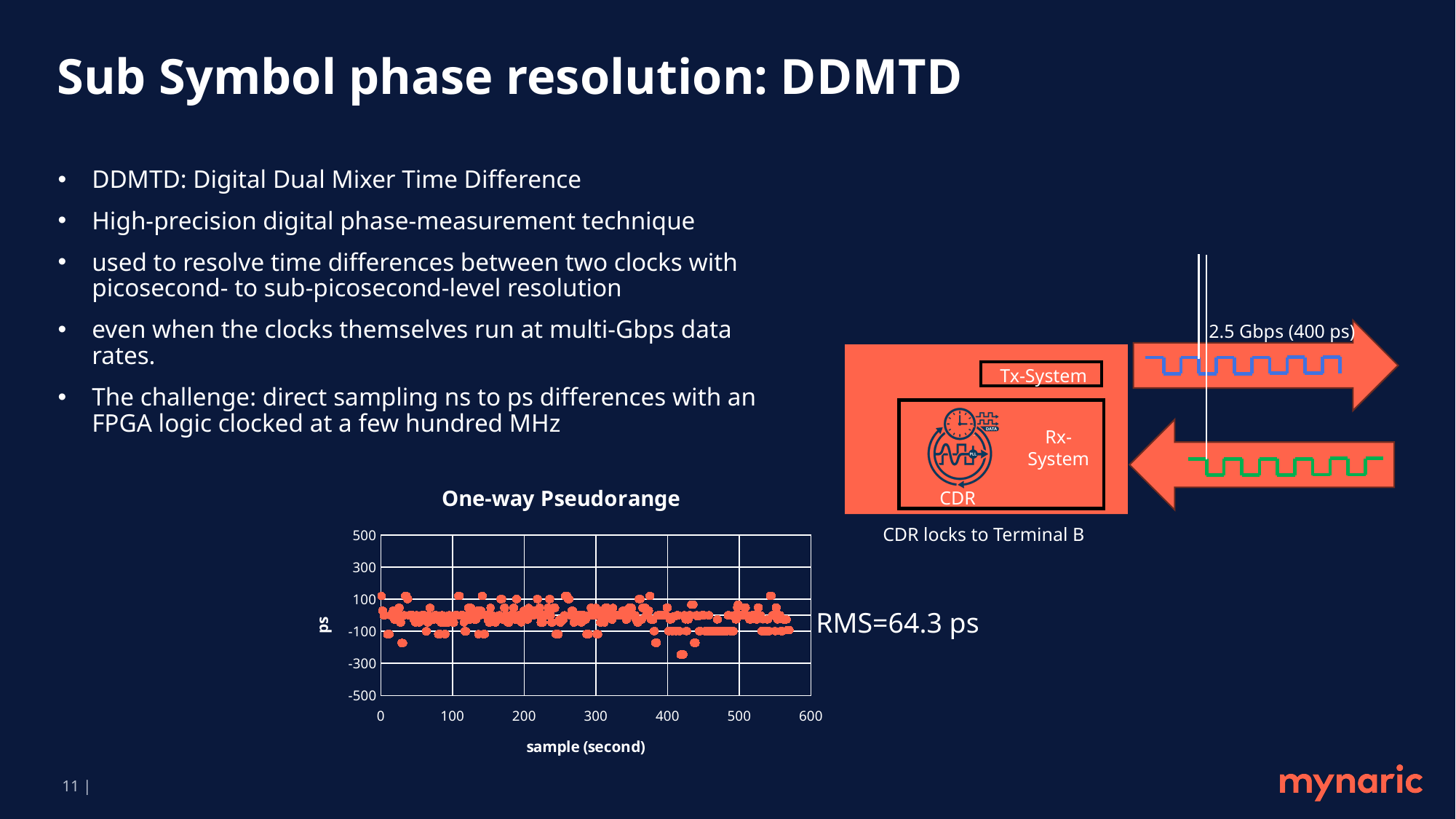
What is the label of the x axis on the One-way Pseudorange chart? sample (second) What is the maximum value shown on the y axis of the One-way Pseudorange chart? 500 What RMS value is stated next to the One-way Pseudorange chart? RMS=64.3 ps What is the title of the chart on the slide? One-way Pseudorange What is the label of the y axis on the One-way Pseudorange chart? ps What is the largest tick value on the x axis of the One-way Pseudorange chart? 600 What is the minimum value shown on the y axis of the One-way Pseudorange chart? -500 Do the values on the One-way Pseudorange chart show a clear rising or falling trend along the x axis, or stay roughly flat? roughly flat What is the spacing between consecutive tick marks on the x axis of the One-way Pseudorange chart? 100 What kind of chart is the One-way Pseudorange chart? scatter chart Are all the plotted points on the One-way Pseudorange chart greater or less than -500 ps? greater Are all the plotted points on the One-way Pseudorange chart greater or less than 300 ps? less